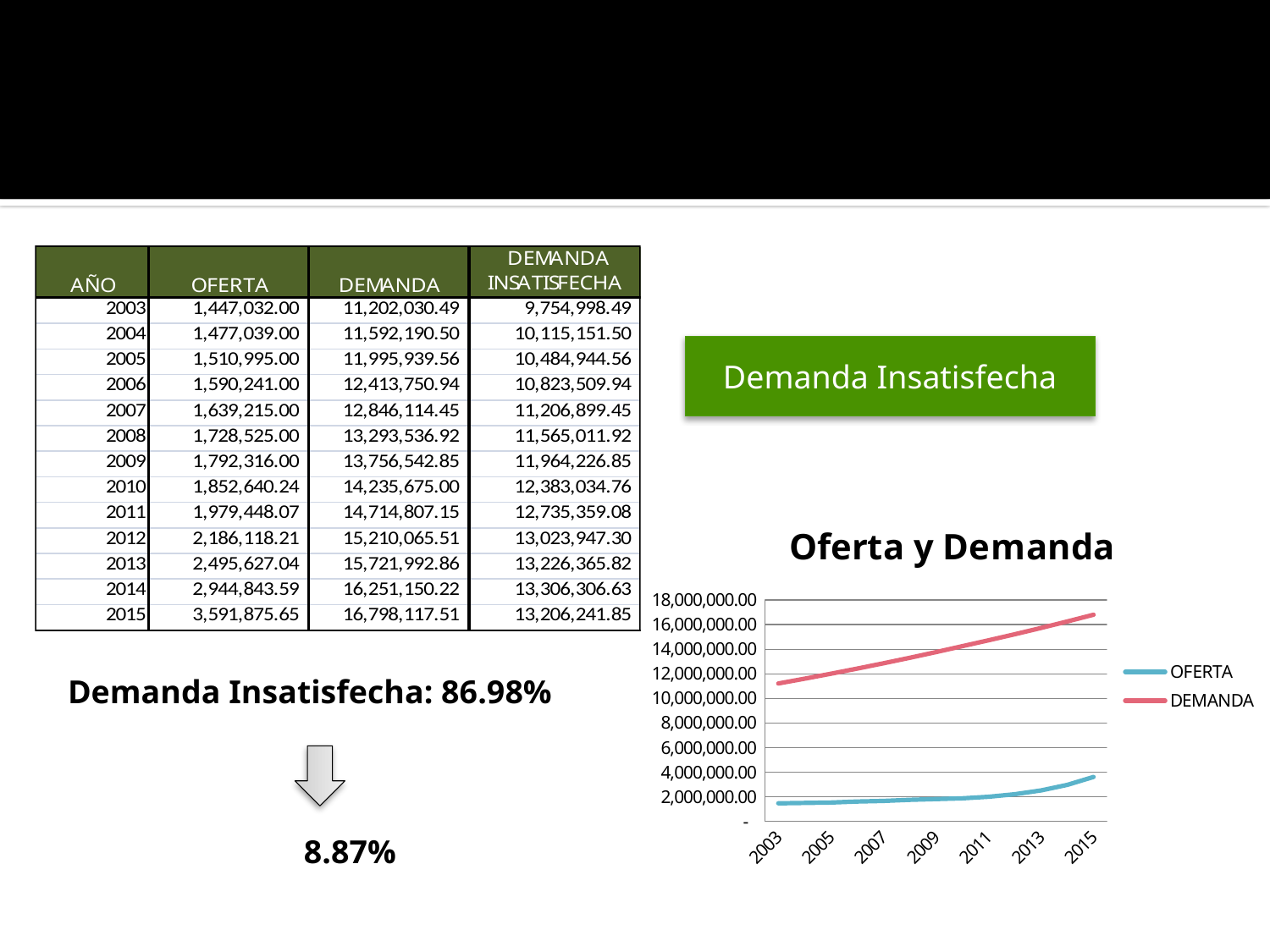
What is the title of the line chart on the slide? Oferta y Demanda What kind of chart is the 'Oferta y Demanda' chart? line chart In the 'Oferta y Demanda' chart, does the DEMANDA line rise or fall from 2003 to 2015? rise How many series does the legend of the 'Oferta y Demanda' chart list? 2 In the 'Oferta y Demanda' chart, is the OFERTA value for 2003 greater or less than 2,000,000.00? less In the 'Oferta y Demanda' chart, does the OFERTA line rise or fall from 2003 to 2015? rise In the 'Oferta y Demanda' chart, which series has the higher value in 2015, OFERTA or DEMANDA? DEMANDA In the 'Oferta y Demanda' chart, is the OFERTA value for 2015 greater or less than 4,000,000.00? less How many year labels are shown on the x axis of the 'Oferta y Demanda' chart? 7 In the 'Oferta y Demanda' chart, is the DEMANDA value for 2015 greater or less than 16,000,000.00? greater What are the two series named in the legend of the 'Oferta y Demanda' chart? OFERTA and DEMANDA